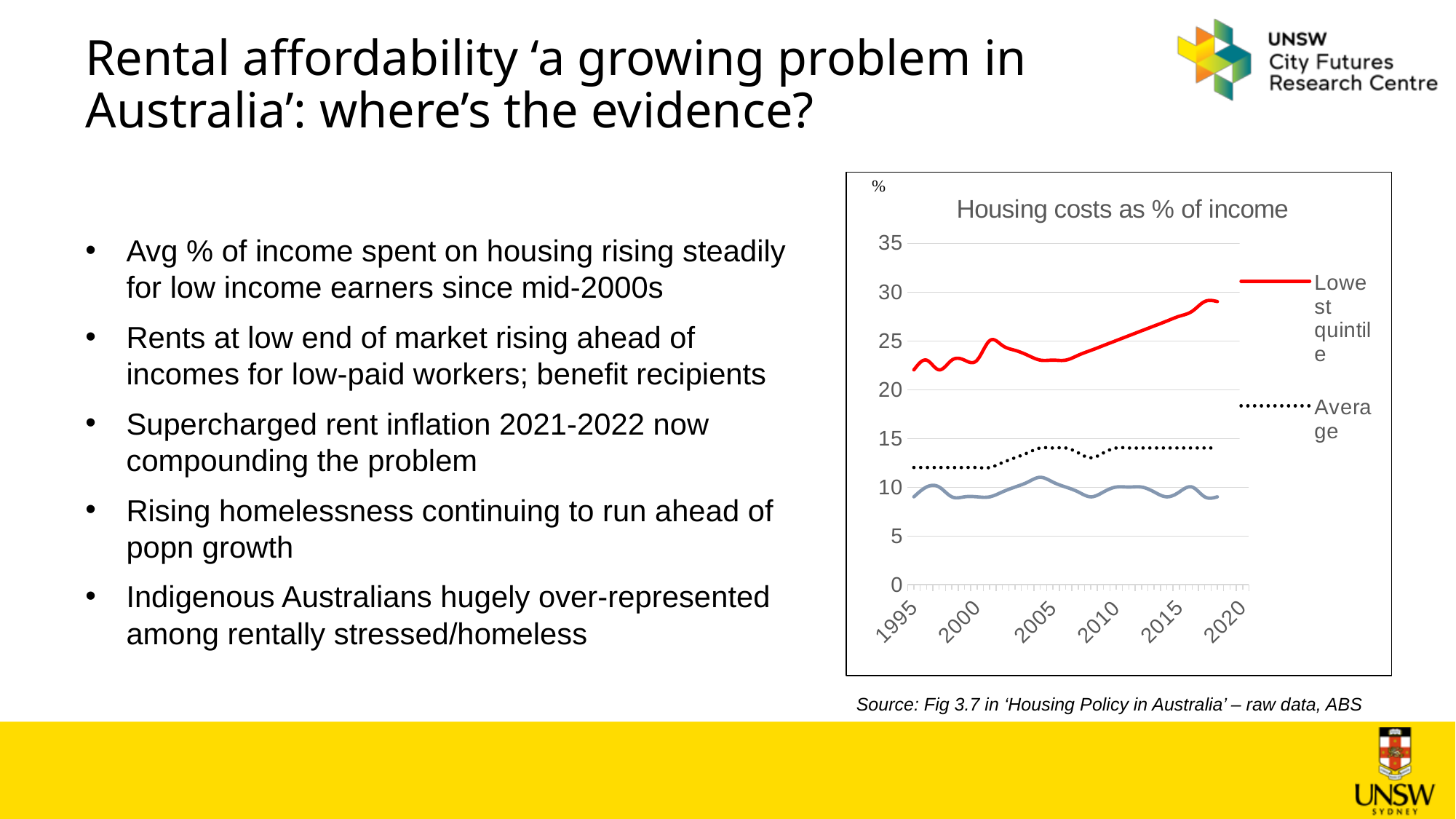
Is the value for the Lowest quintile series in 2010 greater or less than 20? greater In 2010, which series has the higher value: Lowest quintile or Average? Lowest quintile Does the Lowest quintile line rise or fall between 2005 and 2018? rises Which series in the legend has the highest values across the whole period? Lowest quintile Is the value for the Lowest quintile series in 1995 greater or less than 25? less How many series does the chart's legend list? 2 Is the value for the Average series in 1995 greater or less than 15? less What is the title of the chart? Housing costs as % of income Which series is shown as a dotted line in the chart? Average What kind of chart is shown on the slide? Line chart